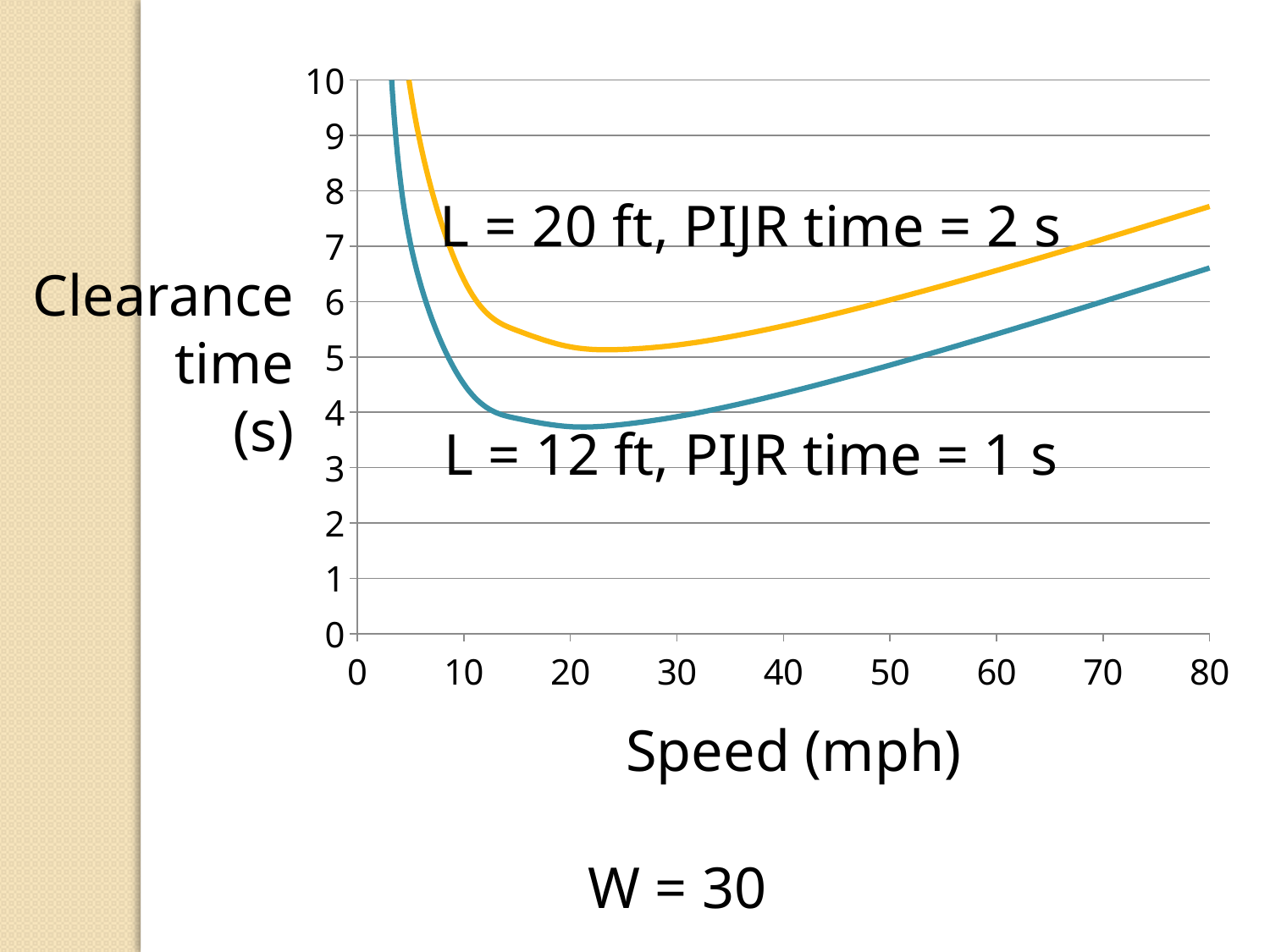
At a speed of 40 mph, which curve has the higher clearance time: L = 20 ft, PIJR time = 2 s or L = 12 ft, PIJR time = 1 s? L = 20 ft, PIJR time = 2 s Between 30 mph and 80 mph, does the clearance time for the L = 12 ft, PIJR time = 1 s curve rise or fall as speed increases? rise How many curves are plotted on the chart? 2 Between 5 mph and 15 mph, does the clearance time for the L = 20 ft, PIJR time = 2 s curve rise or fall as speed increases? fall Is the clearance time for the L = 12 ft, PIJR time = 1 s curve at 40 mph greater or less than 5? less What is the title of the y axis? Clearance time (s) Is the clearance time for the L = 12 ft, PIJR time = 1 s curve at 80 mph greater or less than 7? less Is the clearance time for the L = 20 ft, PIJR time = 2 s curve at 80 mph greater or less than 7? greater What kind of chart is shown on the slide? line chart What is the title of the x axis? Speed (mph)